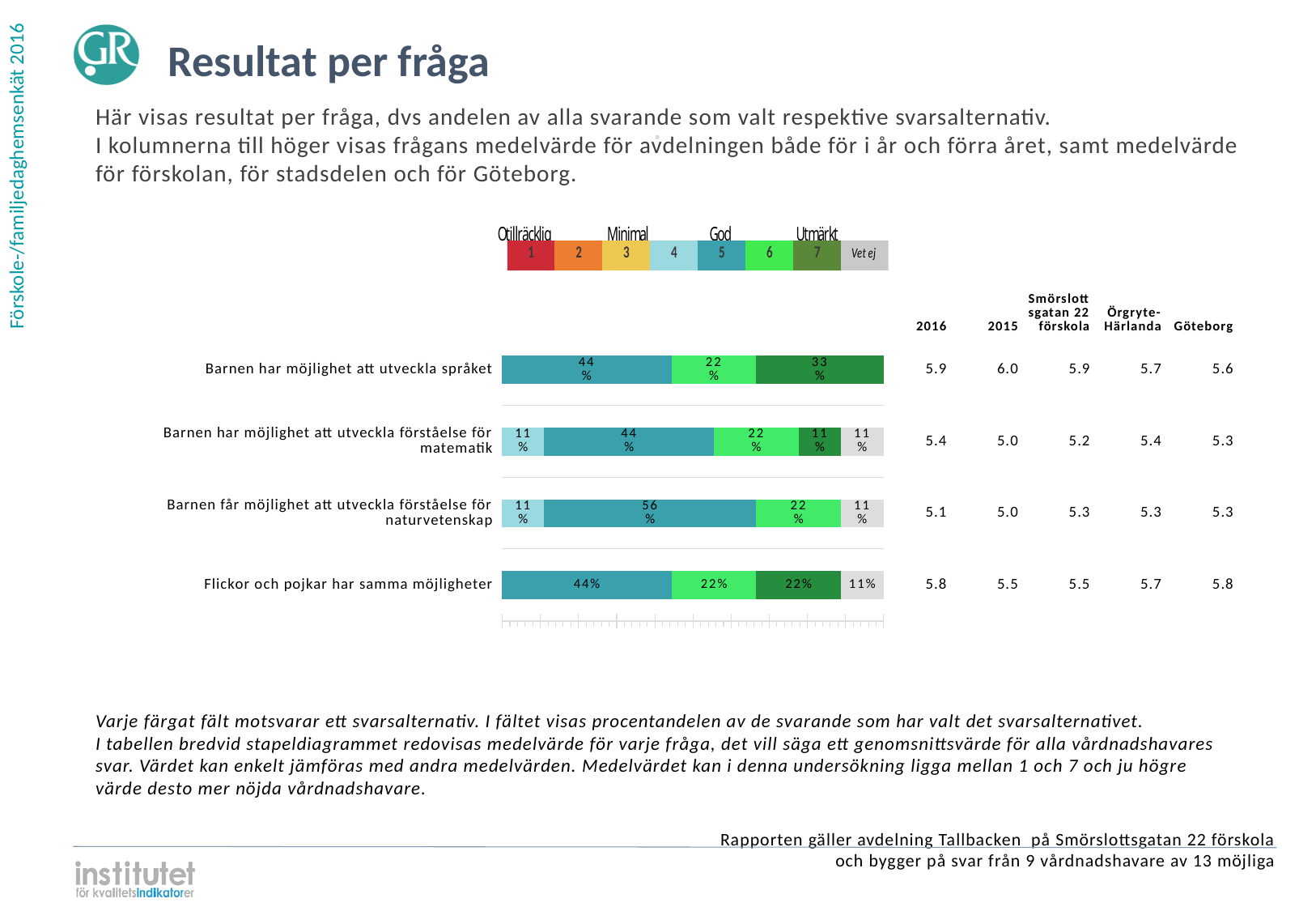
How many questions (categories) are plotted in the bar chart? 4 What percentage of respondents answered 'Vet ej' for 'Flickor och pojkar har samma möjligheter'? 11% What kind of chart is shown on the slide? Stacked bar chart Which question has the highest 2016 mean value in the table? Barnen har möjlighet att utveckla språket (5.9) How many response options does the legend above the chart list, including 'Vet ej'? 8 What percentage of respondents chose option 7 (dark green) for 'Barnen har möjlighet att utveckla språket'? 33% What is the difference between the option 5 share and the option 6 share for 'Barnen får möjlighet att utveckla förståelse för naturvetenskap'? 34% What is the 2016 mean value for 'Flickor och pojkar har samma möjligheter'? 5.8 What percentage of respondents chose option 5 (teal) for 'Barnen får möjlighet att utveckla förståelse för naturvetenskap'? 56% What is the Göteborg mean value for 'Barnen har möjlighet att utveckla förståelse för matematik'? 5.3 Which response option has the largest share for 'Barnen har möjlighet att utveckla förståelse för matematik'? 5 (44%) Which is larger for 'Barnen har möjlighet att utveckla språket': the share for option 6 or the share for option 7? Option 7 (33%)